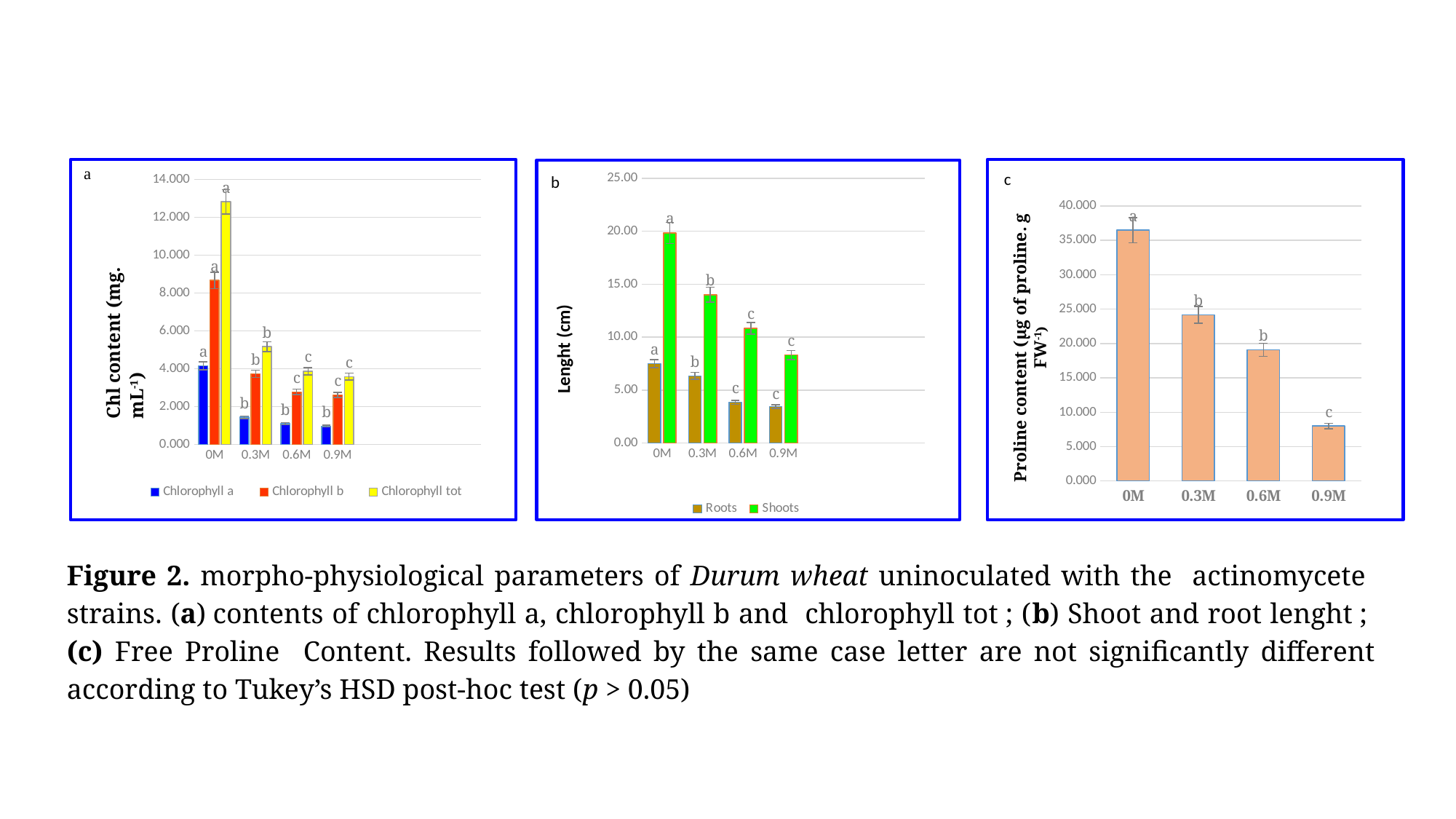
In chart b (Lenght), do the Shoots values rise or fall from 0M to 0.9M? fall In chart b (Lenght), is the Roots value for 0M greater or less than 5.00? greater In chart c (Proline content), is the value for 0M greater or less than 35.000? greater In chart b (Lenght), is the Shoots value for 0.3M greater or less than 15.00? less What kind of chart is chart c (Proline content)? bar chart In chart a (Chl content), how many series does the legend list? 3 In chart c (Proline content), how many categories are shown on the x axis? 4 In chart a (Chl content), which category has the highest Chlorophyll tot value? 0M In chart b (Lenght), which category has the highest Shoots value? 0M In chart c (Proline content), which category has the lowest value? 0.9M